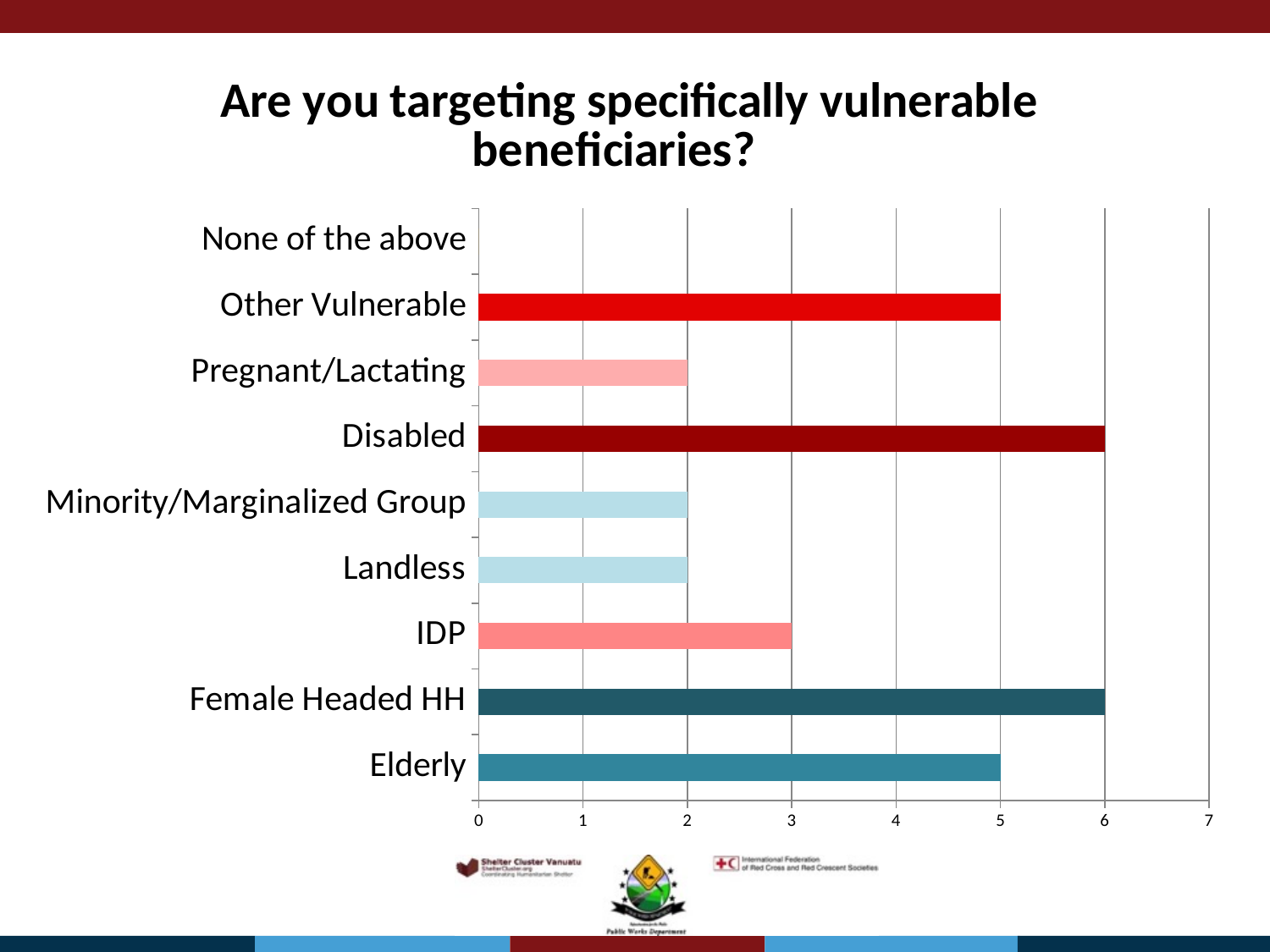
What is the title of the chart? Are you targeting specifically vulnerable beneficiaries? How many categories are shown on the chart? 9 What is the value for Disabled? 6 Which is larger, the value for Other Vulnerable or the value for Pregnant/Lactating? Other Vulnerable What is the value for Other Vulnerable? 5 What is the value for IDP? 3 Which category has the lowest value? None of the above What is the value for Elderly? 5 Is the value for Female Headed HH greater or less than 4? greater What is the difference between the values for Disabled and IDP? 3 What kind of chart is shown on the slide? bar chart What is the value for Landless? 2